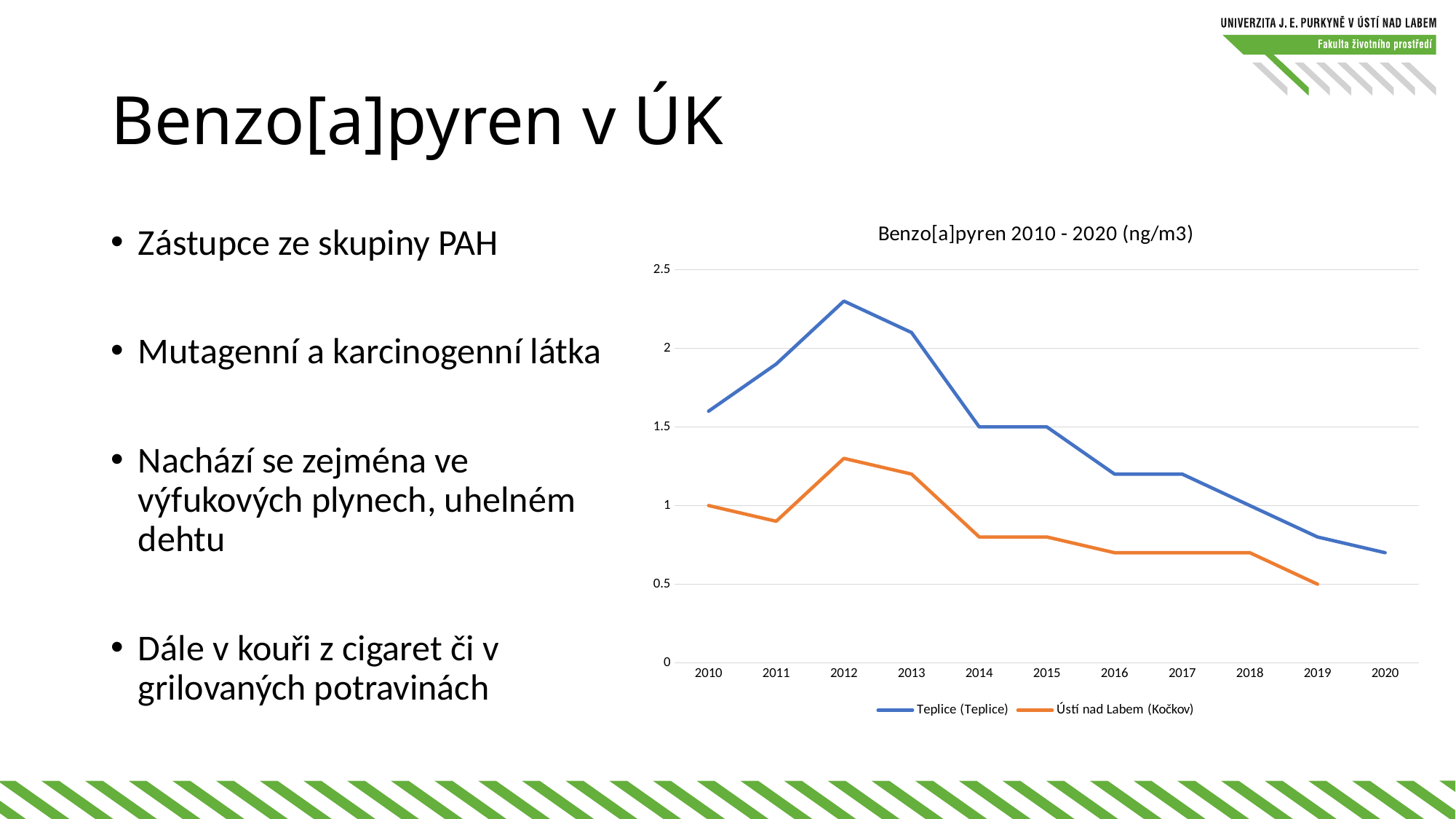
What kind of chart is shown on the slide? line chart In which year is the Teplice (Teplice) value lowest? 2020 Is the Teplice (Teplice) value in 2020 greater or less than 1? less In which year does the Ústí nad Labem (Kočkov) series reach its highest value? 2012 What is the title of the chart? Benzo[a]pyren 2010 - 2020 (ng/m3) Is the Teplice (Teplice) value in 2012 greater or less than 2? greater Is the Ústí nad Labem (Kočkov) value in 2012 greater or less than 1? greater In which year does the Teplice (Teplice) series reach its highest value? 2012 How many years are shown on the x axis? 11 Do the Teplice (Teplice) values rise or fall from 2012 to 2020? fall Which series has the higher value in 2013, Teplice (Teplice) or Ústí nad Labem (Kočkov)? Teplice (Teplice) How many series does the legend list? 2